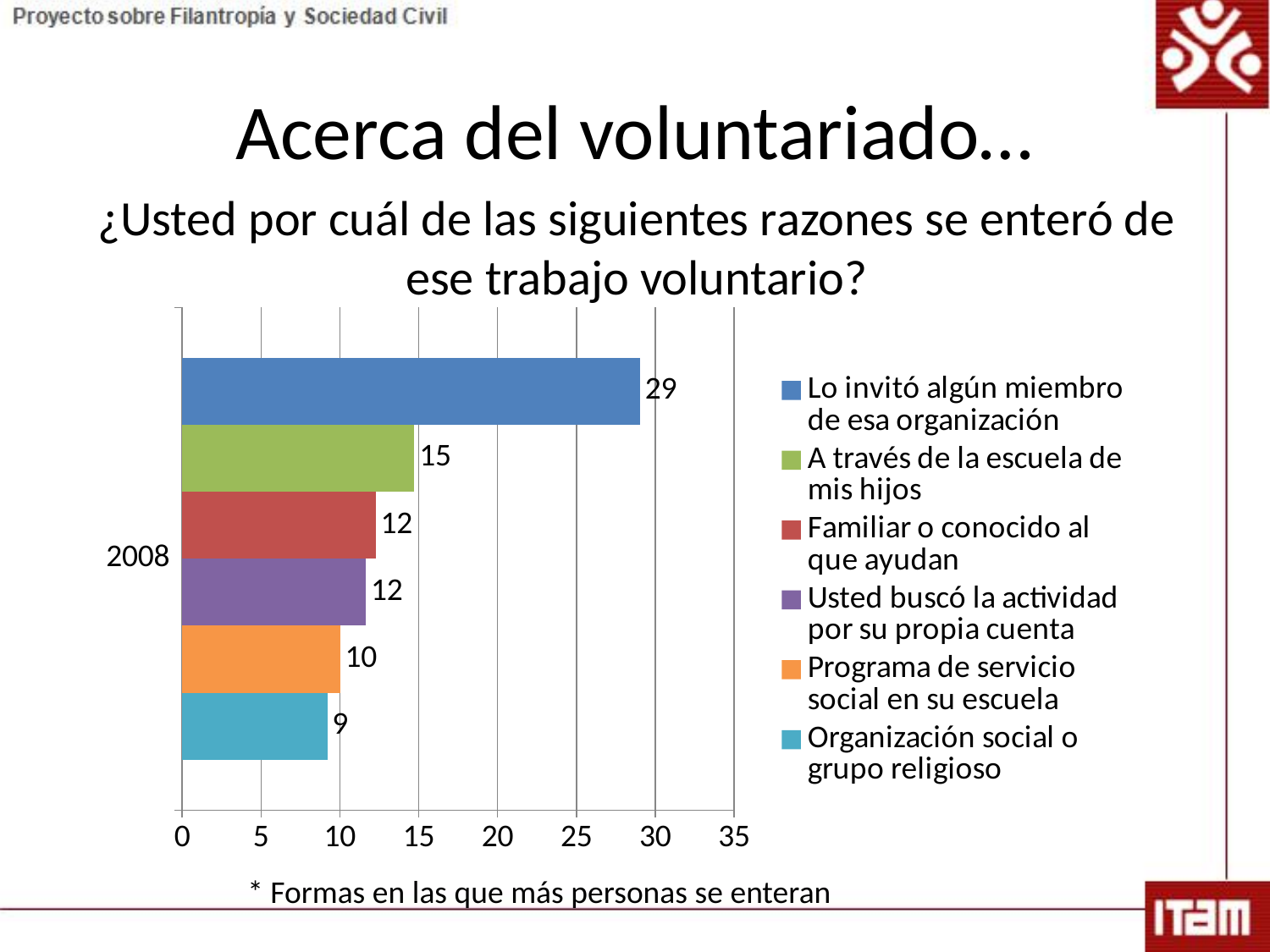
What is the value for "Lo invitó algún miembro de esa organización" in 2008? 29 What is the value for "Programa de servicio social en su escuela" in 2008? 10 Which series has the highest value in 2008? Lo invitó algún miembro de esa organización What year label appears on the vertical axis of the chart? 2008 What kind of chart is shown on the slide? bar chart Which series has the lowest value in 2008? Organización social o grupo religioso Is the value for "Lo invitó algún miembro de esa organización" greater or less than 25? greater What is the value for "A través de la escuela de mis hijos" in 2008? 15 How many series does the legend list? 6 What is the difference between the values for "Lo invitó algún miembro de esa organización" and "A través de la escuela de mis hijos"? 14 What is the value for "Organización social o grupo religioso" in 2008? 9 Which is larger: the value for "Familiar o conocido al que ayudan" or the value for "Organización social o grupo religioso"? Familiar o conocido al que ayudan